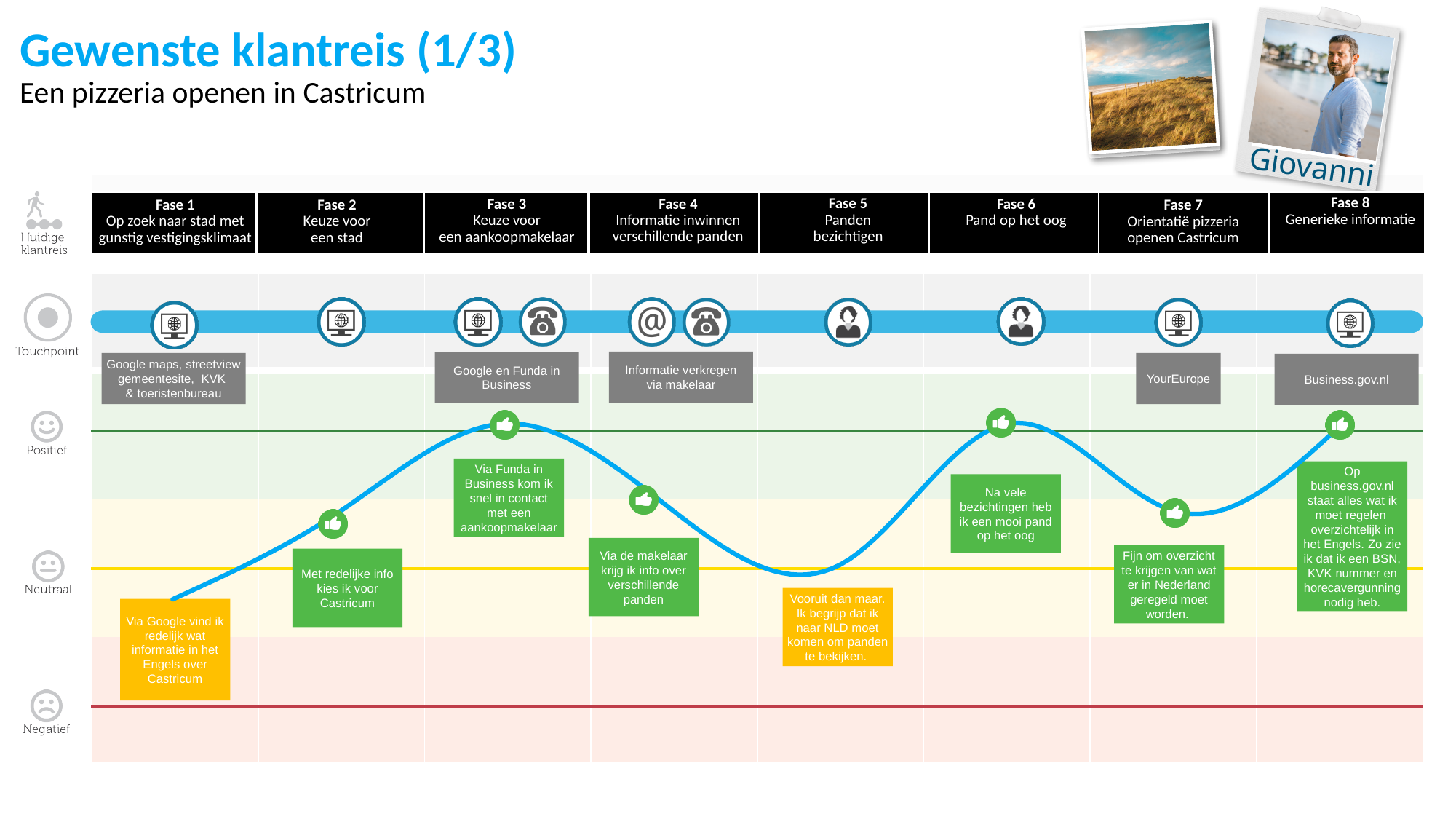
How many sentiment levels are labelled on the left axis (Positief, Neutraal, Negatief)? 3 What is the touchpoint listed for Fase 7? YourEurope Does the sentiment line rise or fall from Fase 1 to Fase 3? Rise Which is higher on the sentiment line, Fase 3 or Fase 4? Fase 3 What is the name of Fase 6? Pand op het oog Does the sentiment line ever drop into the Negatief zone? No Which is higher on the sentiment line, Fase 6 or Fase 7? Fase 6 What is the title of the slide? Gewenste klantreis (1/3) What is the touchpoint listed for Fase 8? Business.gov.nl How many phases (fases) are shown along the top of the customer journey? 8 What kind of chart is used to show the customer's sentiment across the phases? Line chart Does the sentiment line rise or fall from Fase 3 to Fase 5? Fall